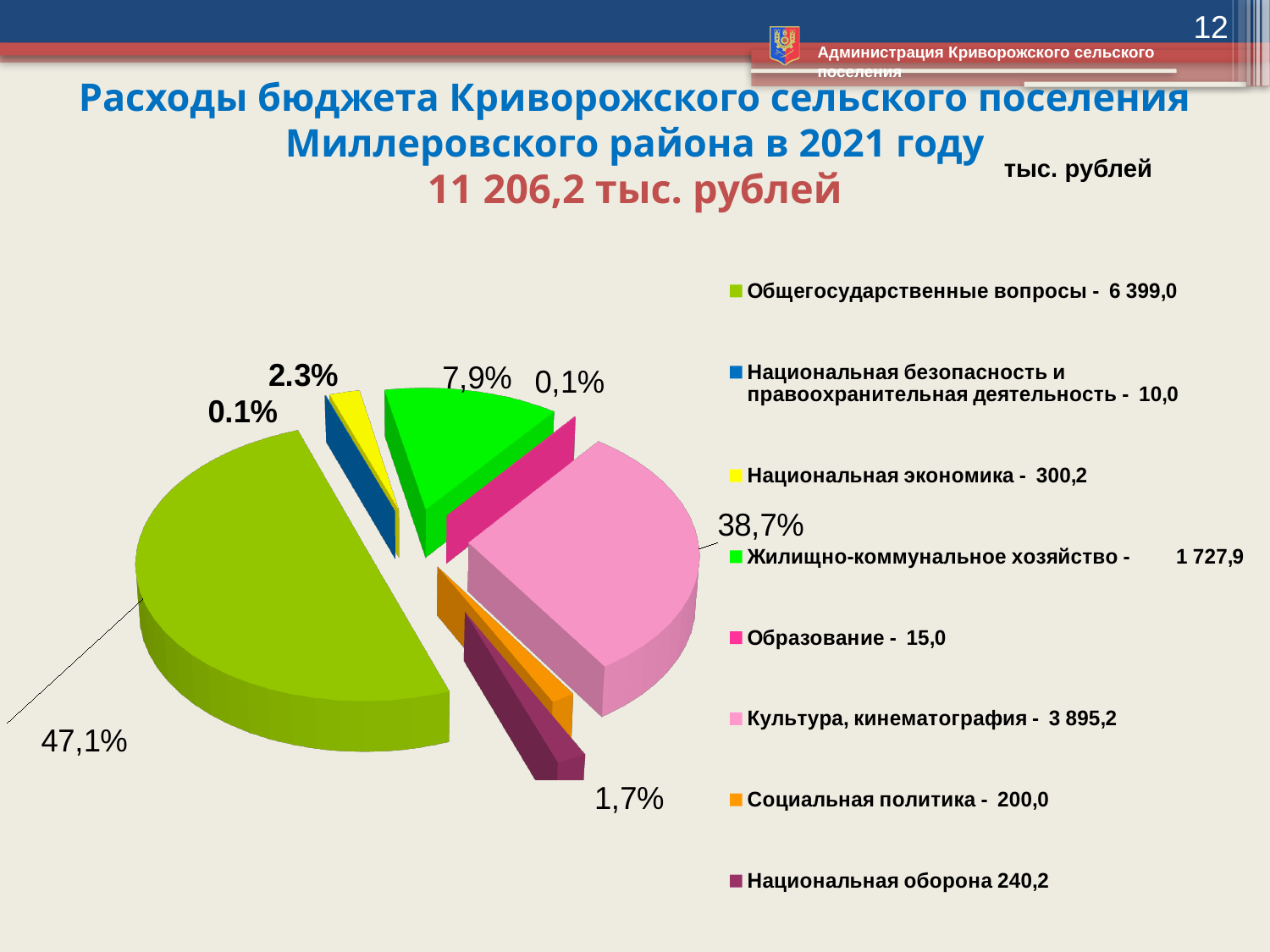
Which expenditure category has the smallest value? Национальная безопасность и правоохранительная деятельность What is the difference between the values for Общегосударственные вопросы and Культура, кинематография? 2 503,8 What is the value shown in the legend for Национальная оборона? 240,2 What is the value shown in the legend for Общегосударственные вопросы? 6 399,0 What kind of chart is shown on the slide? pie chart Which is larger: Социальная политика or Национальная оборона? Национальная оборона What is the value shown in the legend for Образование? 15,0 What share of the pie does Общегосударственные вопросы take, according to the data label? 47,1% What is the value shown in the legend for Культура, кинематография? 3 895,2 Which expenditure category has the largest value? Общегосударственные вопросы How many expenditure categories does the legend of the pie chart list? 8 What total budget expenditure amount is stated in the chart title? 11 206,2 тыс. рублей